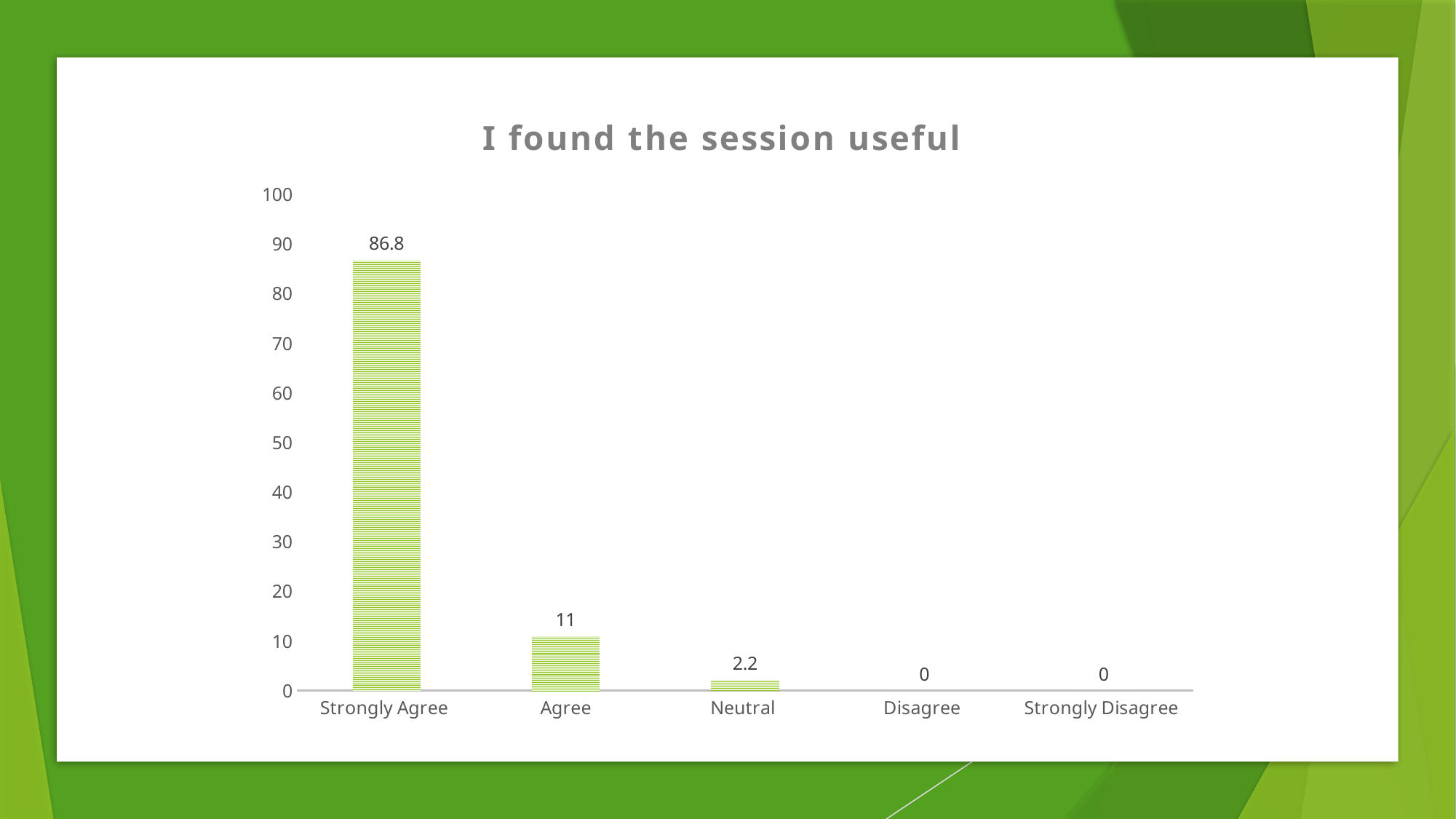
What is the value for Disagree? 0 Which category has the highest value? Strongly Agree What kind of chart is shown? bar chart What is the difference between the values for Strongly Agree and Agree? 75.8 Do the values rise or fall from Strongly Agree to Strongly Disagree? fall Which is larger, the value for Agree or the value for Neutral? Agree What is the value for Agree? 11 How many categories are shown on the x axis? 5 Is the value for Strongly Agree greater or less than 80? greater What is the value for Strongly Agree? 86.8 What is the value for Neutral? 2.2 What is the title of the chart? I found the session useful